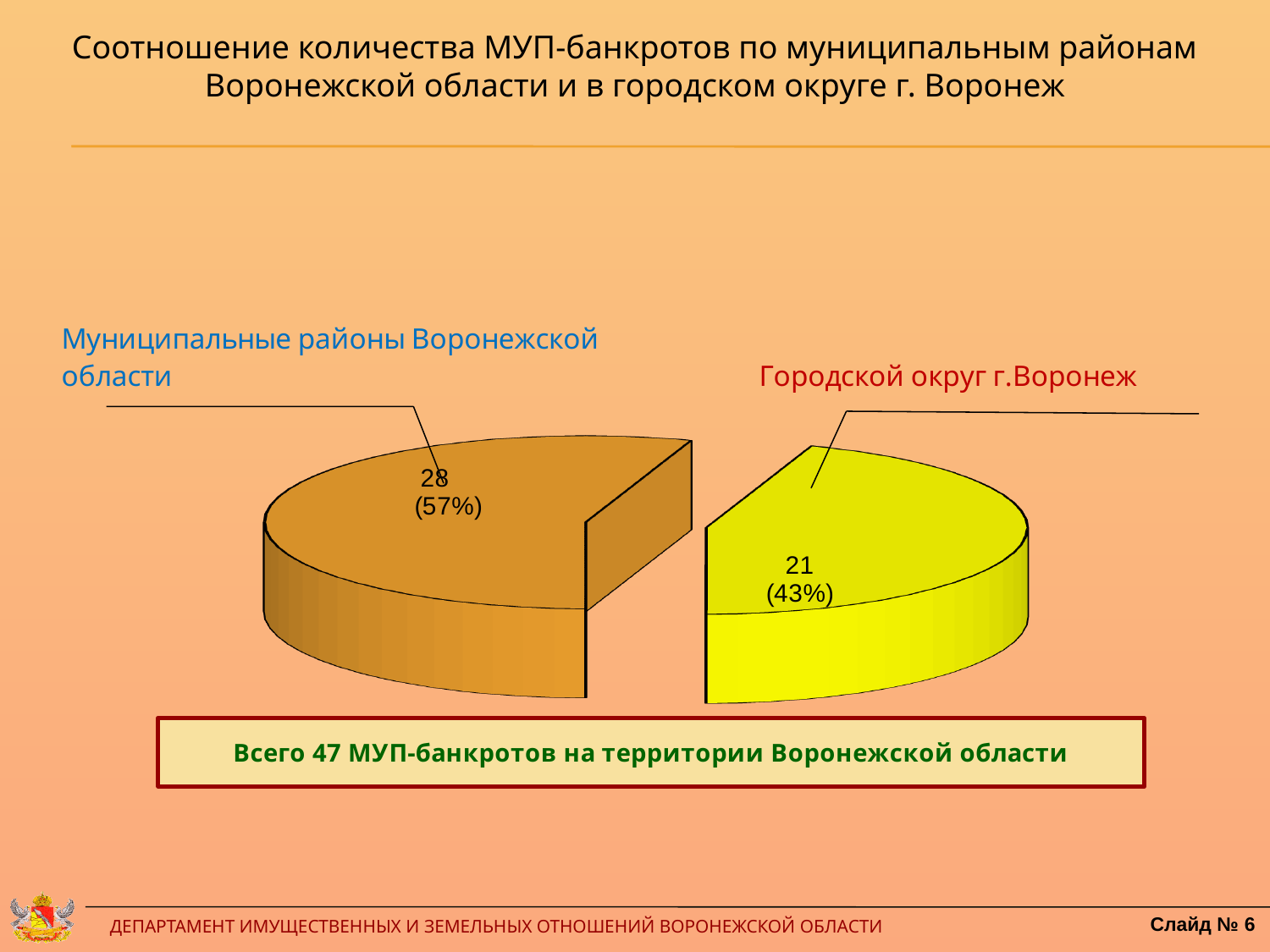
Which slice is the largest? Муниципальные районы Воронежской области What colour is the slice for Городской округ г.Воронеж? Yellow Which slice is the smallest? Городской округ г.Воронеж What share of the pie does Городской округ г.Воронеж represent? 43% What is the difference between the values for Муниципальные районы Воронежской области and Городской округ г.Воронеж? 7 Which is larger: the value for Муниципальные районы Воронежской области or for Городской округ г.Воронеж? Муниципальные районы Воронежской области What is the total of the two slices in the pie chart? 47 What share of the pie does Муниципальные районы Воронежской области represent? 57% What is the value for Городской округ г.Воронеж? 21 What kind of chart is shown on the slide? Pie chart How many slices does the pie chart have? 2 What is the value for Муниципальные районы Воронежской области? 28